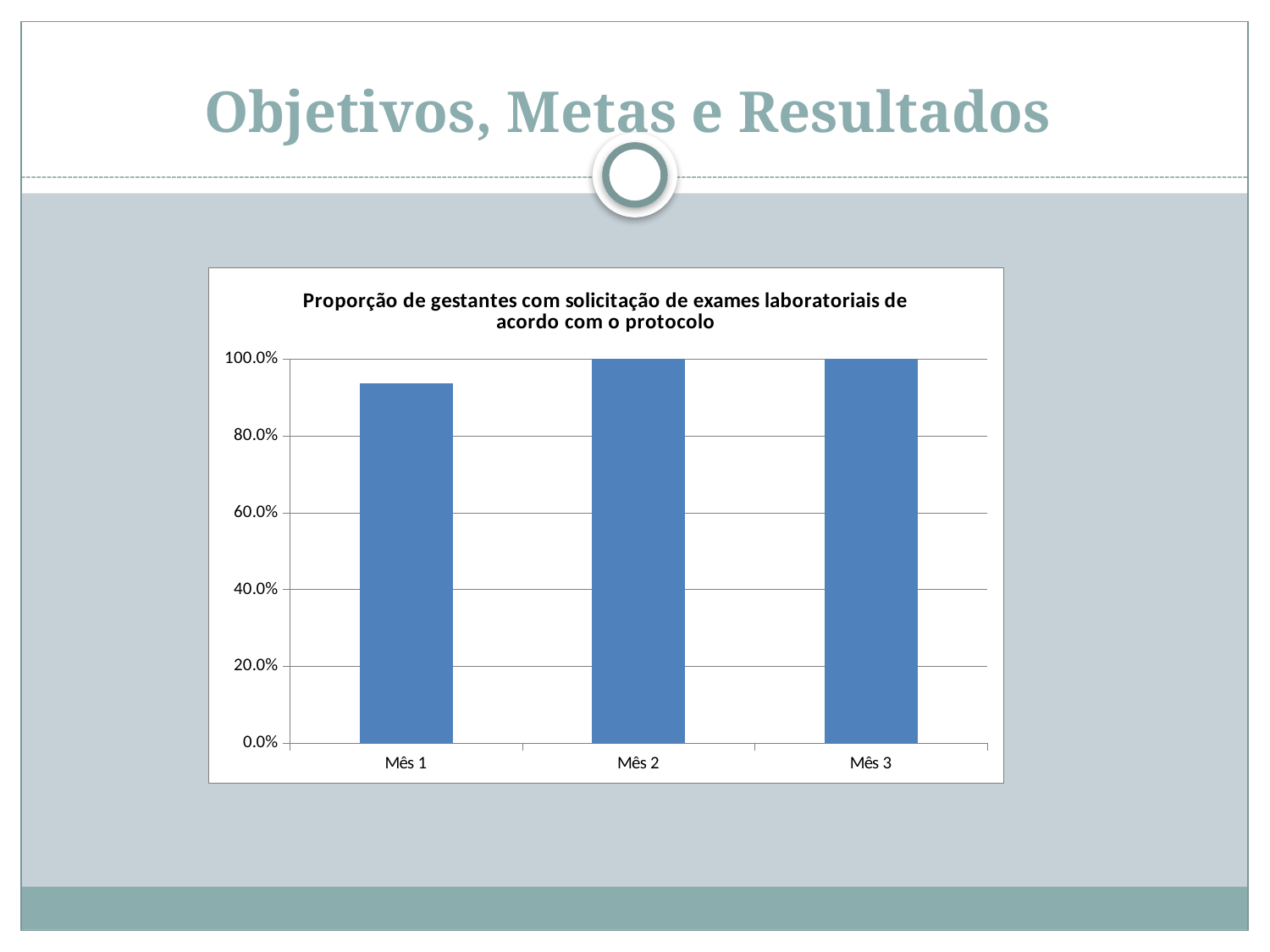
Which month has the lowest value? Mês 1 Does the value rise or fall from Mês 1 to Mês 2? rise Which is larger, the value for Mês 1 or the value for Mês 2? Mês 2 What is the title of the chart? Proporção de gestantes com solicitação de exames laboratoriais de acordo com o protocolo How many categories (months) are shown on the x axis of the chart? 3 What kind of chart is shown on the slide? bar chart Is the value for Mês 1 greater or less than 80.0%? greater What is the highest value shown on the y axis of the chart? 100.0% What is the value for Mês 3? 100.0% What is the value for Mês 2? 100.0% Is the value for Mês 1 greater or less than 100.0%? less